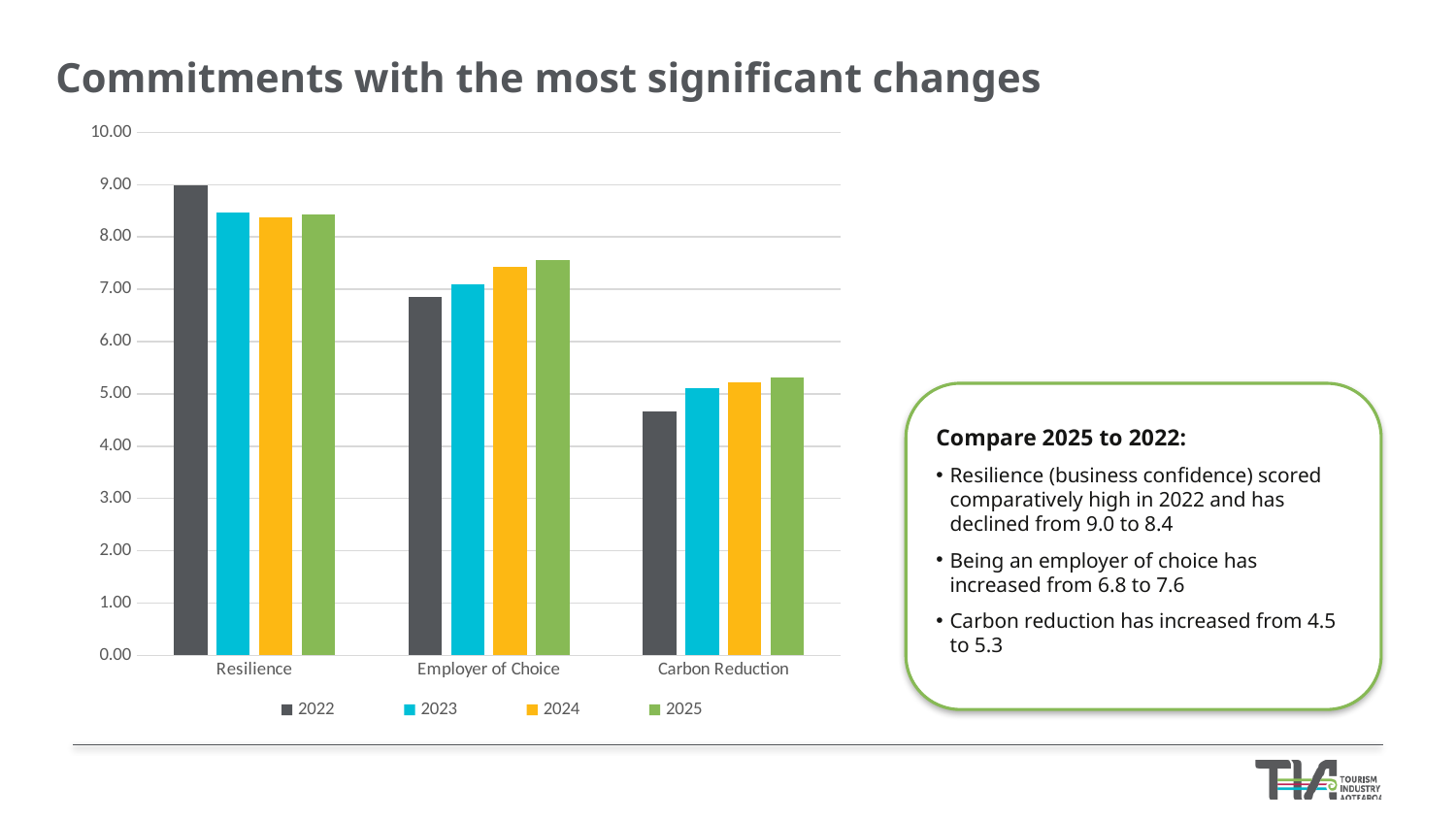
Which category has the lowest value for the 2025 series? Carbon Reduction Do the values for Carbon Reduction rise or fall from 2022 to 2025? rise How many categories are shown on the x axis of the chart? 3 How many series does the chart's legend list? 4 Is the 2025 value for Employer of Choice greater or less than 7.00? greater What is the title of the chart on the slide? Commitments with the most significant changes Which category has the highest value for the 2022 series? Resilience Is the 2022 value for Carbon Reduction greater or less than 5.00? less What kind of chart is shown on the slide? bar chart Is the 2022 value for Resilience greater or less than 8.00? greater For Employer of Choice, which is larger: the 2022 value or the 2025 value? 2025 For Resilience, which is larger: the 2022 value or the 2023 value? 2022